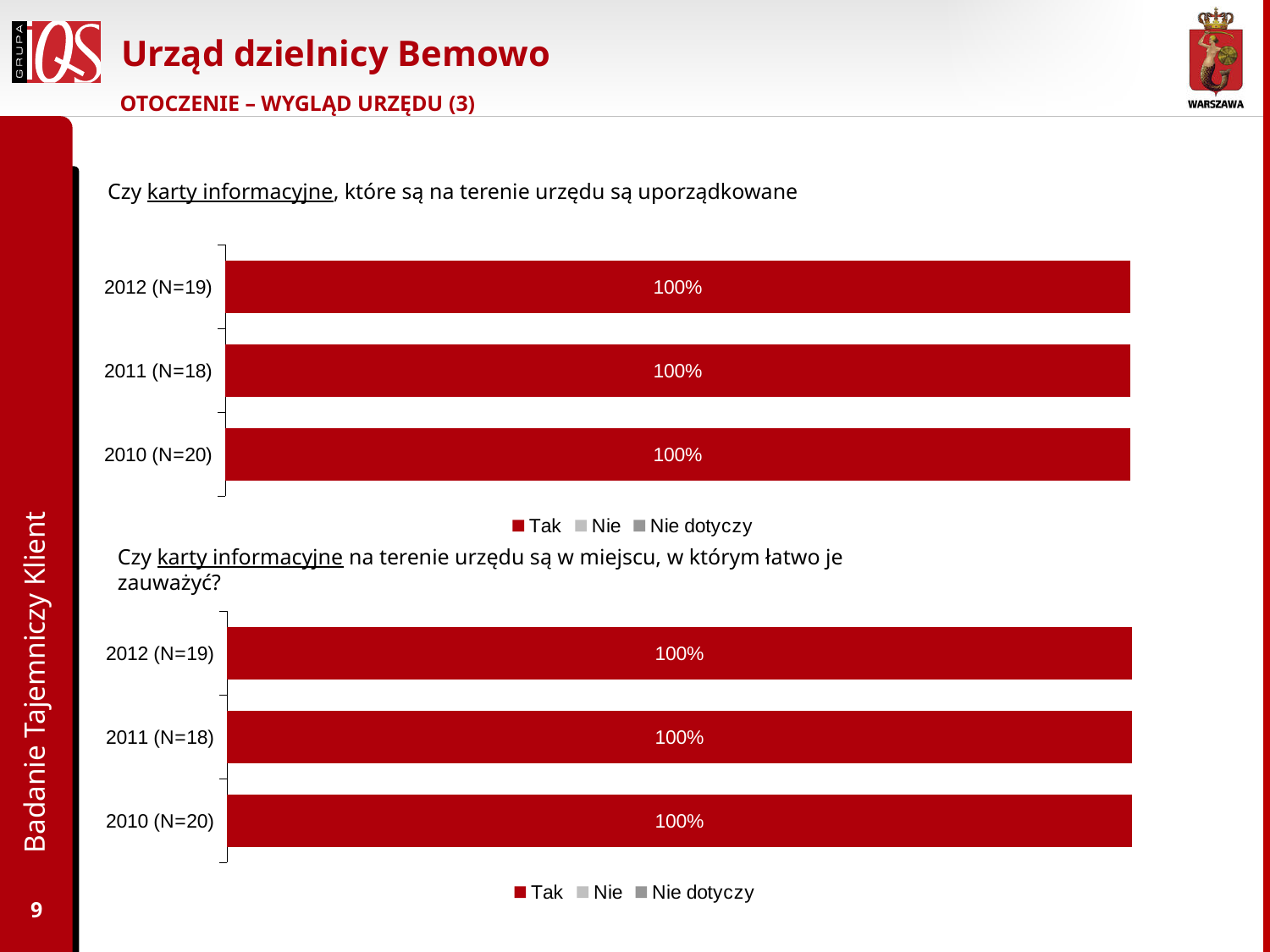
How many series does the legend of the bottom chart list? 3 In the bottom chart (Czy karty informacyjne na terenie urzędu są w miejscu, w którym łatwo je zauważyć?), what is the value for Tak in 2012 (N=19)? 100% What are the legend entries of the top chart? Tak, Nie, Nie dotyczy What kind of chart is the top chart? Stacked horizontal bar chart How many categories (years) are shown in the top chart? 3 What is the sample size (N) shown for the 2011 category in the bottom chart? N=18 In the top chart (Czy karty informacyjne, które są na terenie urzędu są uporządkowane), what is the value for Tak in 2012 (N=19)? 100% In the top chart, what is the difference between the Tak value for 2012 (N=19) and the Tak value for 2010 (N=20)? 0% In the bottom chart, what is the total of the stacked bar for 2010 (N=20)? 100% In the bottom chart (Czy karty informacyjne na terenie urzędu są w miejscu, w którym łatwo je zauważyć?), what is the value for Tak in 2011 (N=18)? 100% In the bottom chart, do the Tak values rise, fall or stay the same from 2010 to 2012? Stay the same In the top chart (Czy karty informacyjne, które są na terenie urzędu są uporządkowane), what is the value for Tak in 2010 (N=20)? 100%